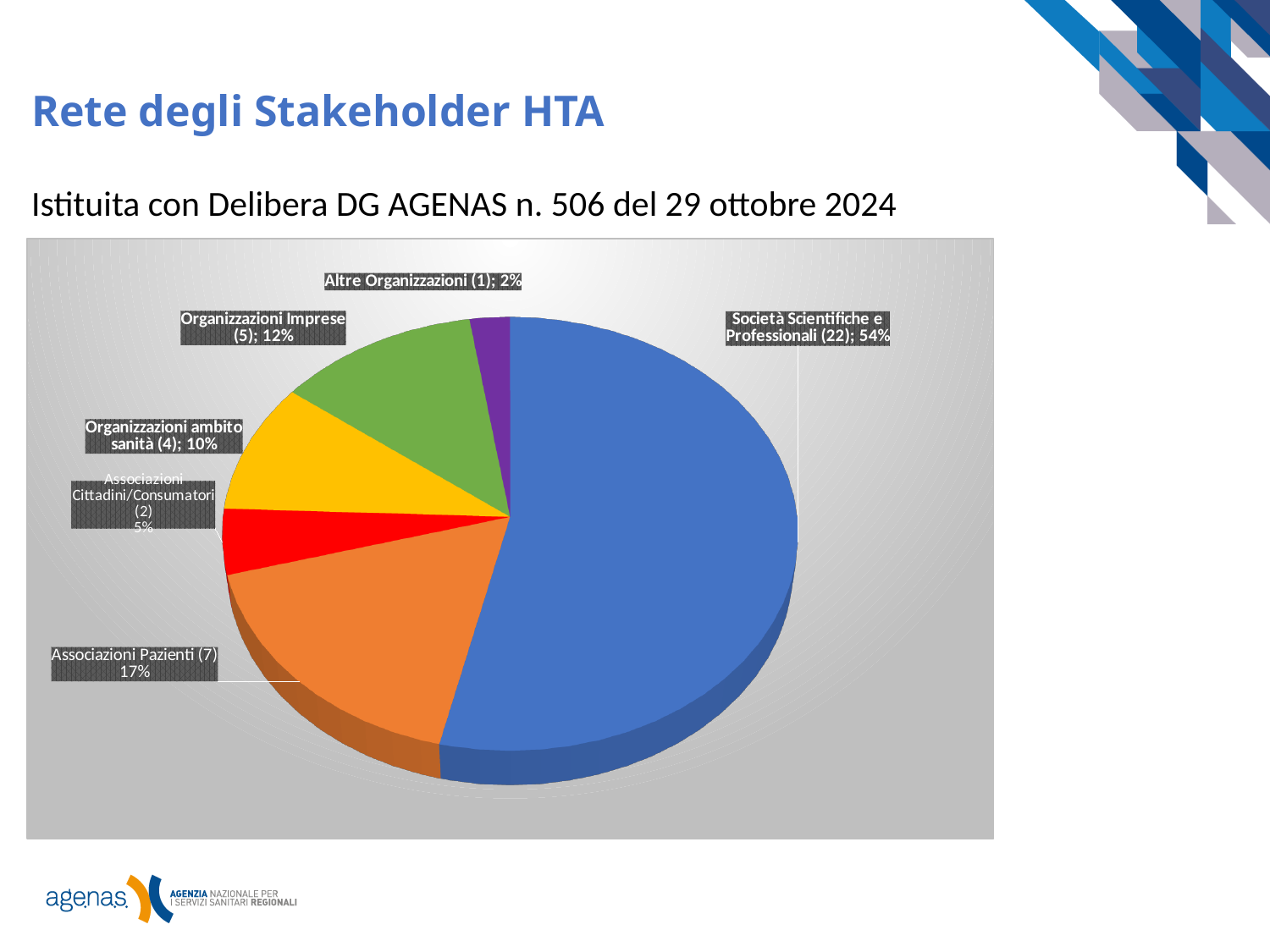
Which category has the largest slice of the pie? Società Scientifiche e Professionali What percentage share does the slice for Società Scientifiche e Professionali have? 54% What is the total number of organisations across all slices of the pie chart? 41 What percentage share does the Organizzazioni Imprese slice have? 12% What kind of chart is shown on the slide? Pie chart How many organisations are counted in the Associazioni Pazienti slice? 7 Which category has the smallest slice of the pie? Altre Organizzazioni What is the difference in percentage points between the Associazioni Pazienti slice and the Associazioni Cittadini/Consumatori slice? 12 What colour is the slice for Associazioni Pazienti? Orange How many organisations are counted in the Organizzazioni ambito sanità slice? 4 How many categories (slices) does the pie chart have? 6 Which slice is larger: Organizzazioni Imprese or Organizzazioni ambito sanità? Organizzazioni Imprese